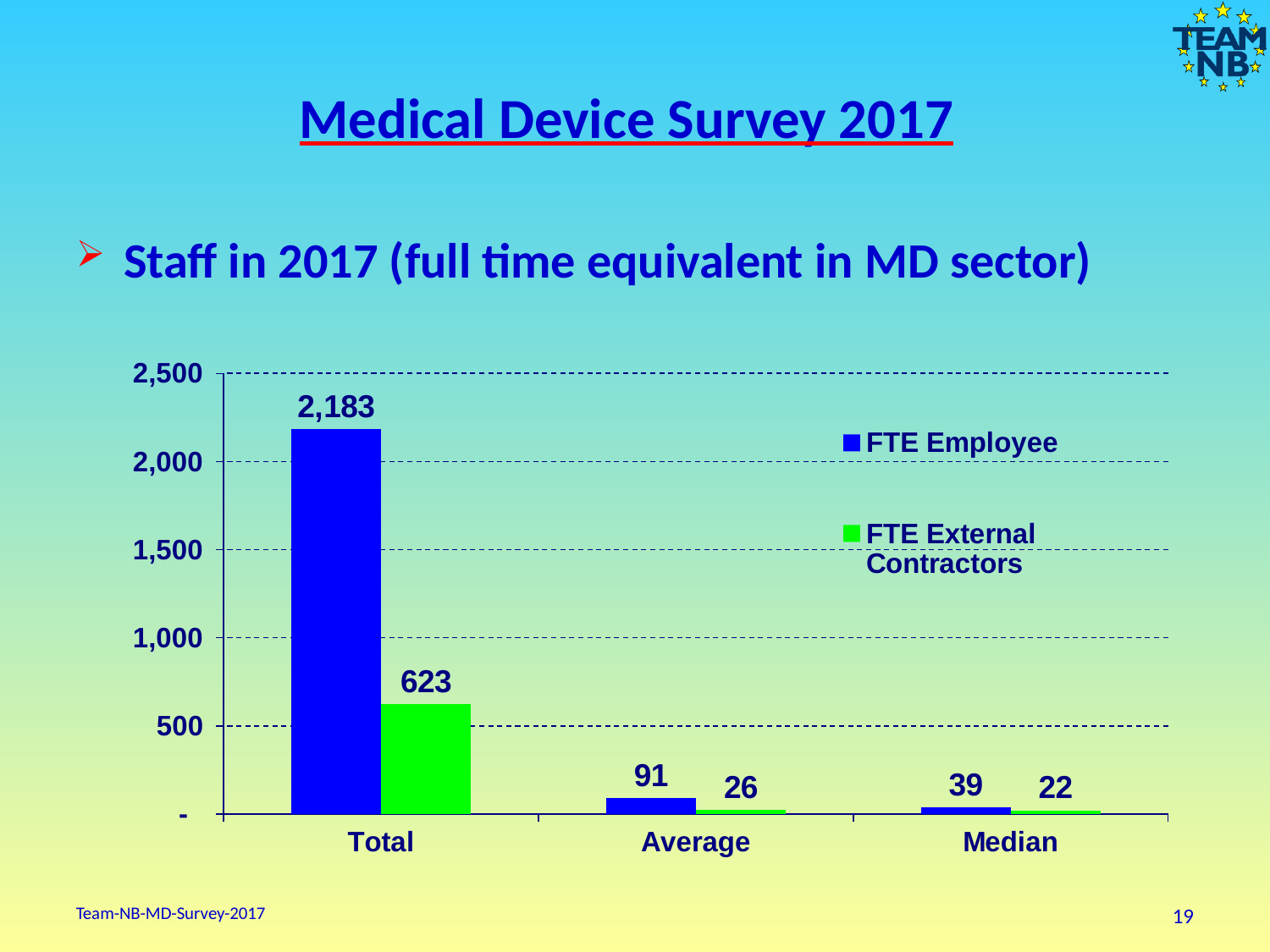
How many categories are shown on the x axis? 3 What is the difference between the FTE Employee and FTE External Contractors values for Total? 1,560 How many series does the legend list? 2 What is the FTE Employee value for Total? 2,183 What kind of chart is shown on the slide? bar chart What is the FTE External Contractors value for Total? 623 Is the FTE Employee value for Total greater or less than 2,000? greater Which category has the highest FTE Employee value? Total What is the FTE External Contractors value for Median? 22 What is the FTE Employee value for Average? 91 Which category has the lowest FTE External Contractors value? Median Which is larger for Average: FTE Employee or FTE External Contractors? FTE Employee